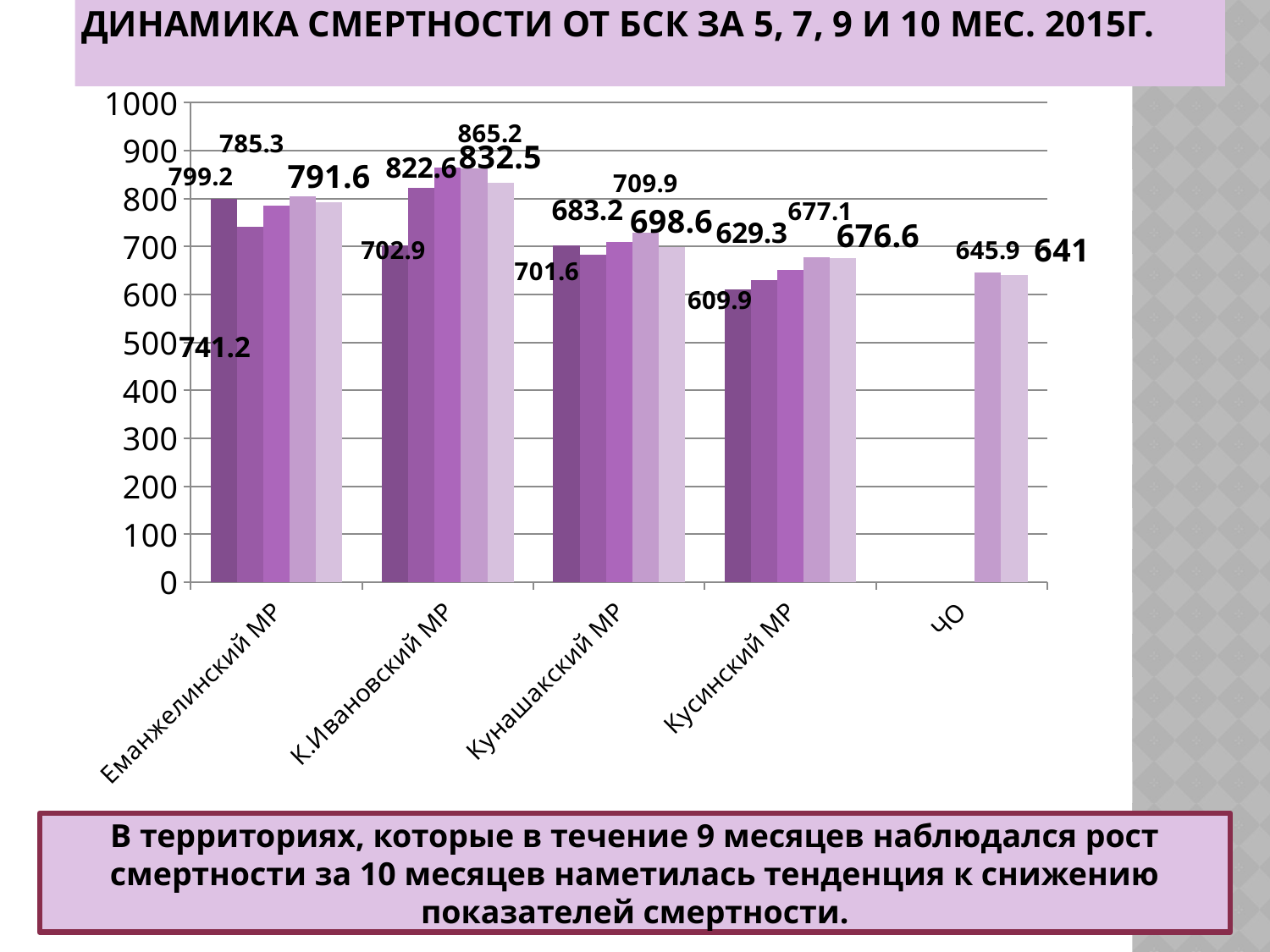
Are all the bars for Кусинский МР greater or less than 700? less Which category has taller bars overall, К.Ивановский МР or Кусинский МР? К.Ивановский МР How many categories are shown on the x axis of the chart? 5 What is the value of the first bar for ЧО? 645.9 What kind of chart is shown on the slide? bar chart Which category contains the highest labelled value on the chart? К.Ивановский МР What is the title of the chart on the slide? ДИНАМИКА СМЕРТНОСТИ ОТ БСК ЗА 5, 7, 9 И 10 МЕС. 2015Г. What is the difference between the two labelled values for ЧО (645.9 and 641)? 4.9 What is the highest data label shown on the chart? 865.2 Which category contains the lowest labelled value on the chart? Кусинский МР What is the value of the rightmost bar for ЧО? 641 What is the lowest data label shown on the chart? 609.9